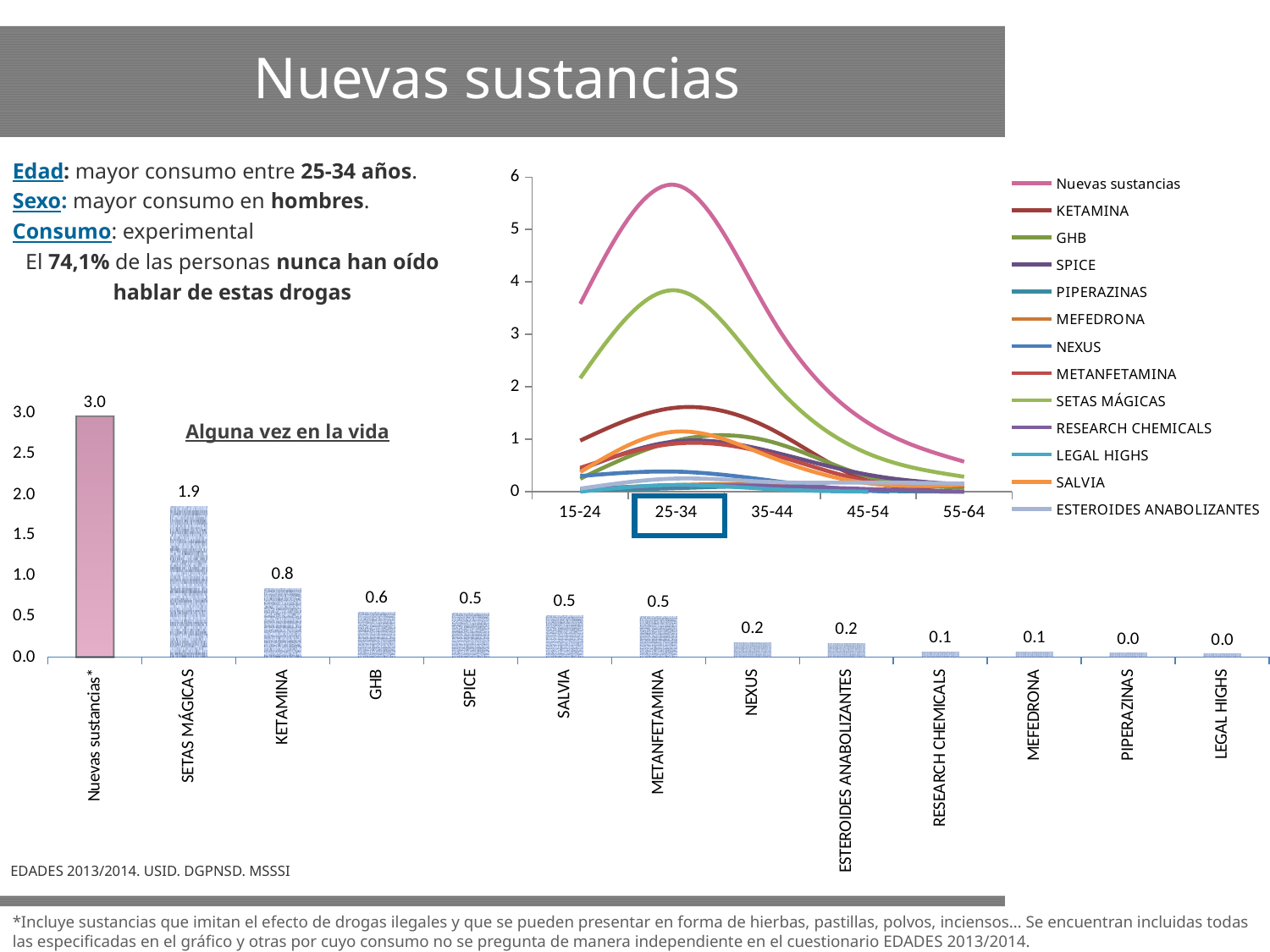
How many categories are shown in the bar chart 'Alguna vez en la vida'? 13 In the line chart in the top right, how many age groups are shown on the x axis? 5 In the line chart in the top right, is the value for Nuevas sustancias at 25-34 greater or less than 5? greater In the bar chart 'Alguna vez en la vida', what is the value for KETAMINA? 0.8 In the bar chart 'Alguna vez en la vida', what is the value for ESTEROIDES ANABOLIZANTES? 0.2 In the bar chart 'Alguna vez en la vida', what is the value for SETAS MÁGICAS? 1.9 How many series does the legend of the line chart in the top right list? 13 In the line chart in the top right, is the value for Nuevas sustancias at 55-64 greater or less than 1? less In the bar chart 'Alguna vez en la vida', which category has the highest value? Nuevas sustancias* In the bar chart 'Alguna vez en la vida', what is the difference between the values for Nuevas sustancias* and SETAS MÁGICAS? 1.1 What kind of chart is the chart in the top right of the slide showing age groups? Line chart In the bar chart 'Alguna vez en la vida', which is larger, the value for GHB or the value for NEXUS? GHB